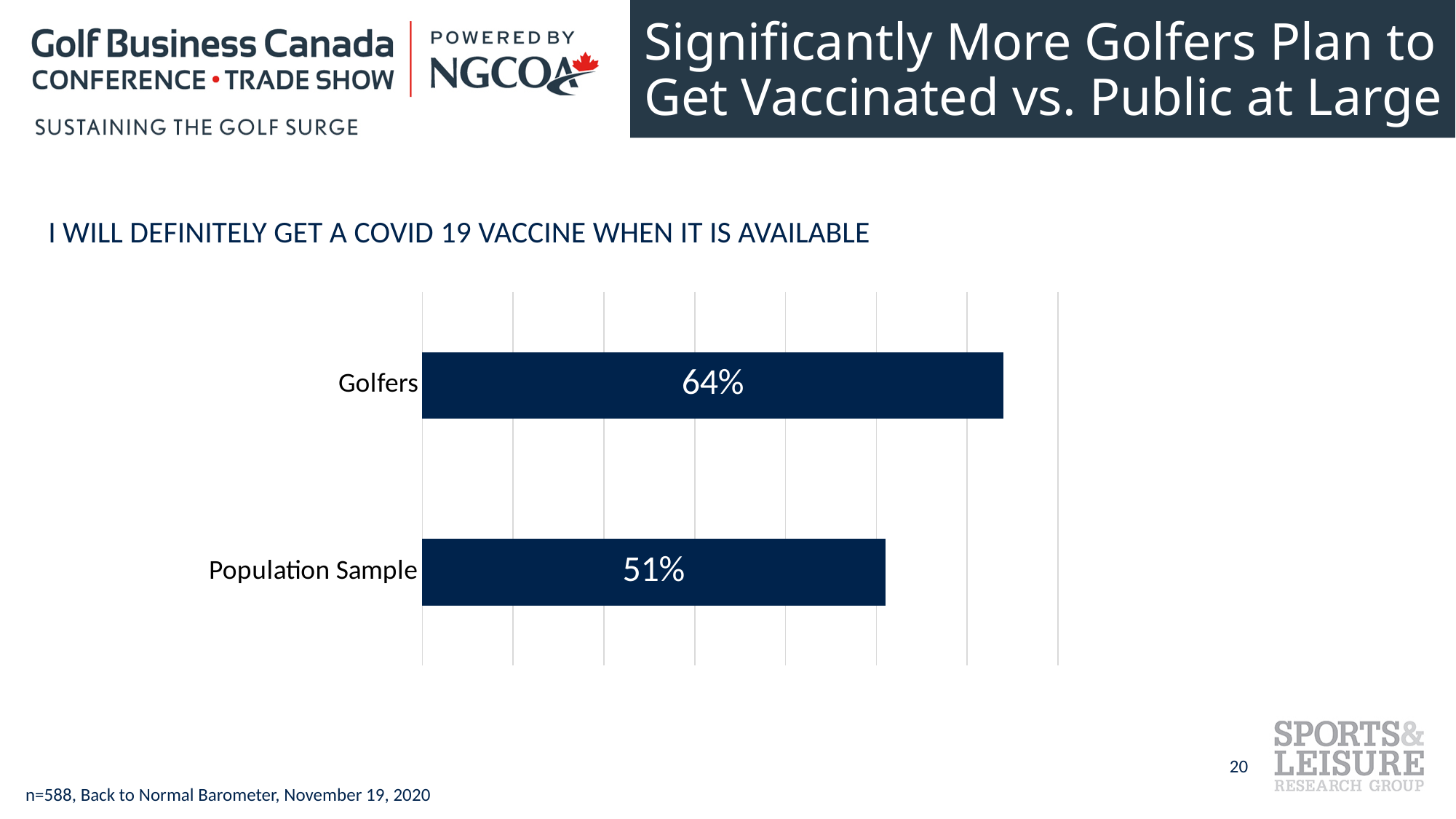
What percentage of the Population Sample say they will definitely get a COVID 19 vaccine when it is available? 51% How many categories are shown in the chart? 2 Which category has the highest value in the chart? Golfers What is the title of the chart on the slide? I WILL DEFINITELY GET A COVID 19 VACCINE WHEN IT IS AVAILABLE Which category has the lowest value in the chart? Population Sample What is the sample size noted at the bottom of the slide? n=588 What is the difference in percentage points between Golfers and the Population Sample? 13 What kind of chart is shown on the slide? Bar chart Which is larger, the value for Golfers or the value for the Population Sample? Golfers What percentage of Golfers say they will definitely get a COVID 19 vaccine when it is available? 64%